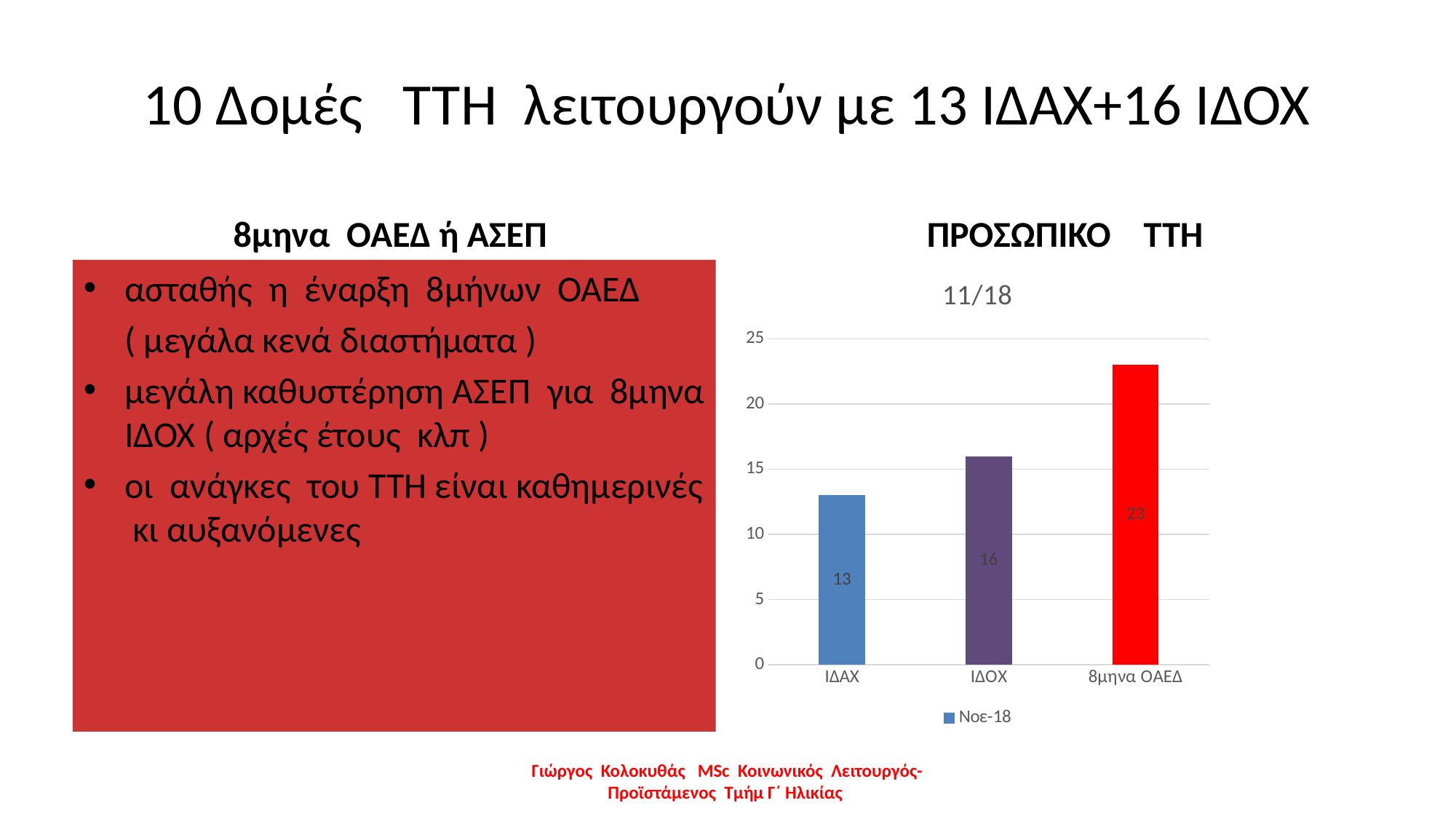
What is the value for ΙΔΑΧ? 13 What is the value for 8μηνα ΟΑΕΔ? 23 Is the value for 8μηνα ΟΑΕΔ greater or less than 20? greater Which is larger, the value for ΙΔΟΧ or the value for ΙΔΑΧ? ΙΔΟΧ Which category has the lowest value? ΙΔΑΧ What is the value for ΙΔΟΧ? 16 Which category has the highest value? 8μηνα ΟΑΕΔ What is the difference between the values for 8μηνα ΟΑΕΔ and ΙΔΑΧ? 10 How many categories are shown on the x axis? 3 What is the title of the chart? 11/18 What kind of chart is shown? bar chart What is the difference between the values for ΙΔΟΧ and ΙΔΑΧ? 3